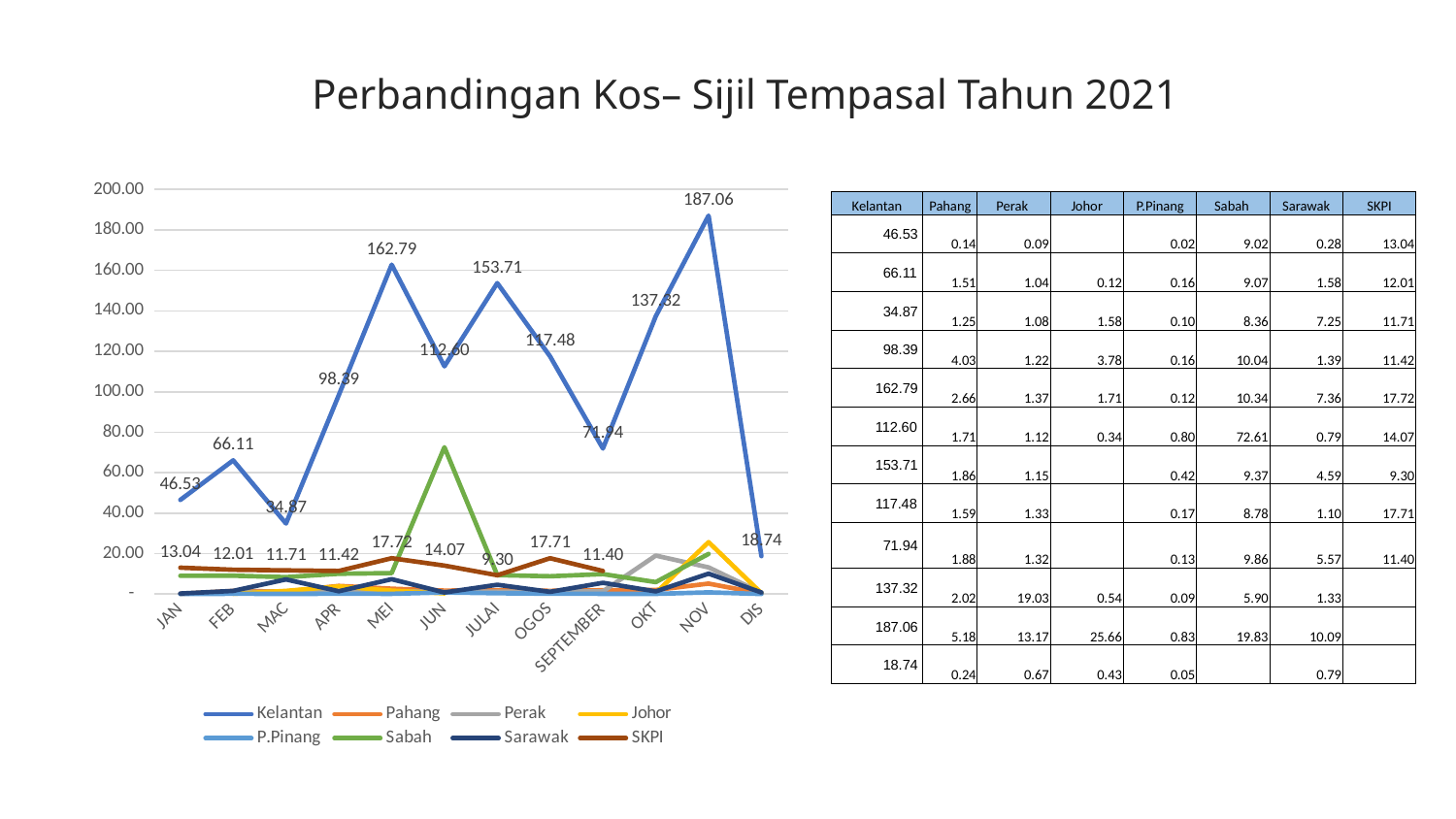
How many months are shown on the x axis of the chart? 12 How many series does the chart legend list? 8 What is the value for SKPI in MEI? 17.72 What is the value for Kelantan in NOV? 187.06 Does the Kelantan line rise or fall from SEPTEMBER to NOV? rise In which month does Kelantan reach its highest value? NOV What kind of chart is shown on the slide? line chart What is the title of the slide? Perbandingan Kos– Sijil Tempasal Tahun 2021 Which is larger for Kelantan: the value in MEI or the value in JULAI? MEI In which month does Kelantan have its lowest value? DIS Is the value for Sabah in JUN greater or less than 60? greater What is the difference between the Kelantan values for NOV and MEI? 24.27